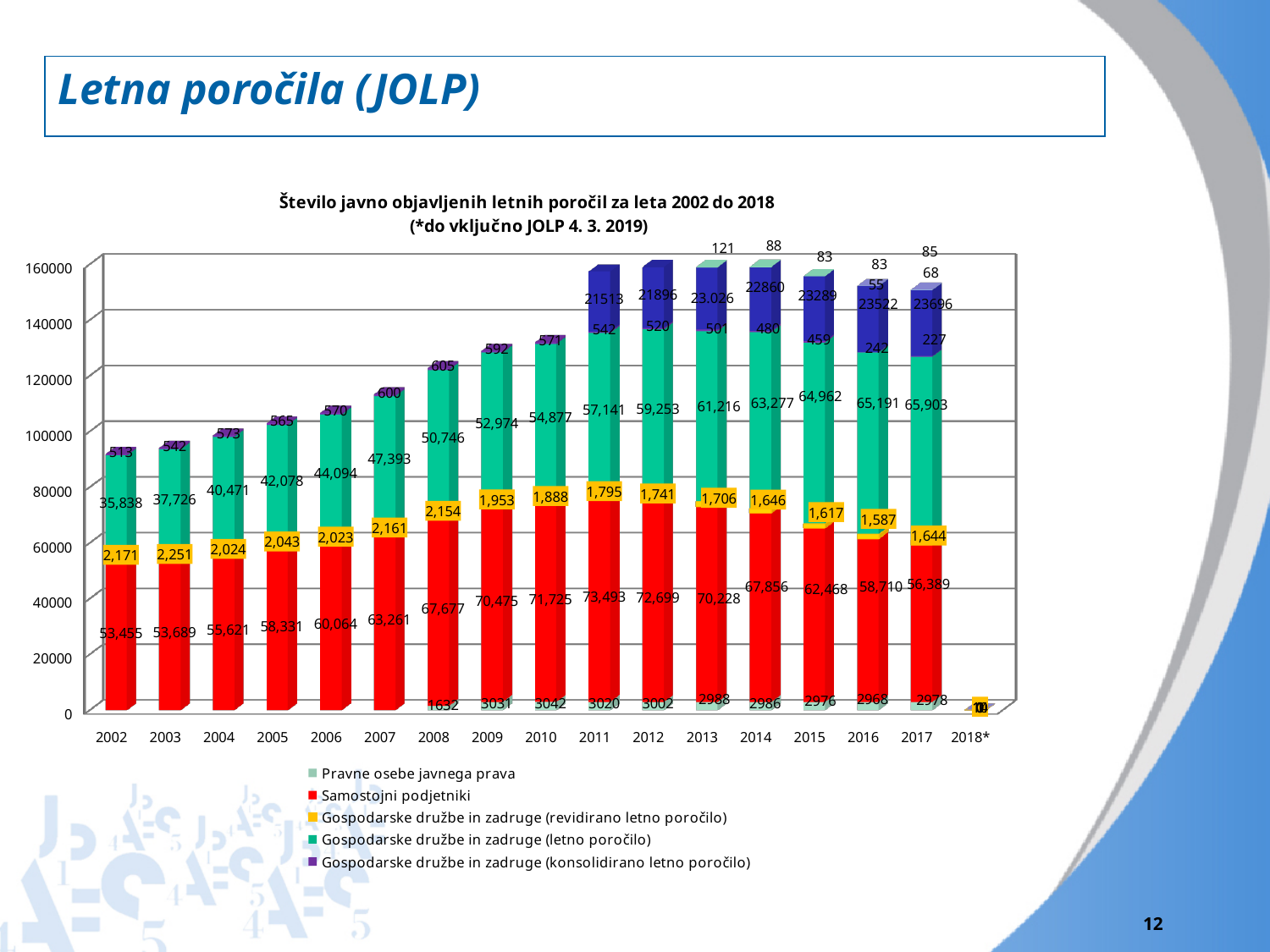
What type of chart is shown on the slide? Stacked bar chart What is the value for Samostojni podjetniki in 2011? 73,493 In which year is the value for Samostojni podjetniki the highest? 2011 What is the value for Pravne osebe javnega prava in 2010? 3042 Which is larger, the Samostojni podjetniki value in 2002 or the Gospodarske družbe in zadruge (letno poročilo) value in 2002? Samostojni podjetniki Does the value for Gospodarske družbe in zadruge (letno poročilo) rise or fall from 2002 to 2017? Rise What is the value for Gospodarske družbe in zadruge (letno poročilo) in 2017? 65,903 How many series does the legend list? 5 How many year categories are shown on the x axis? 17 What is the difference between the Samostojni podjetniki values for 2011 and 2017? 17,104 In which year is the value for Gospodarske družbe in zadruge (letno poročilo) the lowest? 2018* What is the value for Gospodarske družbe in zadruge (revidirano letno poročilo) in 2002? 2,171